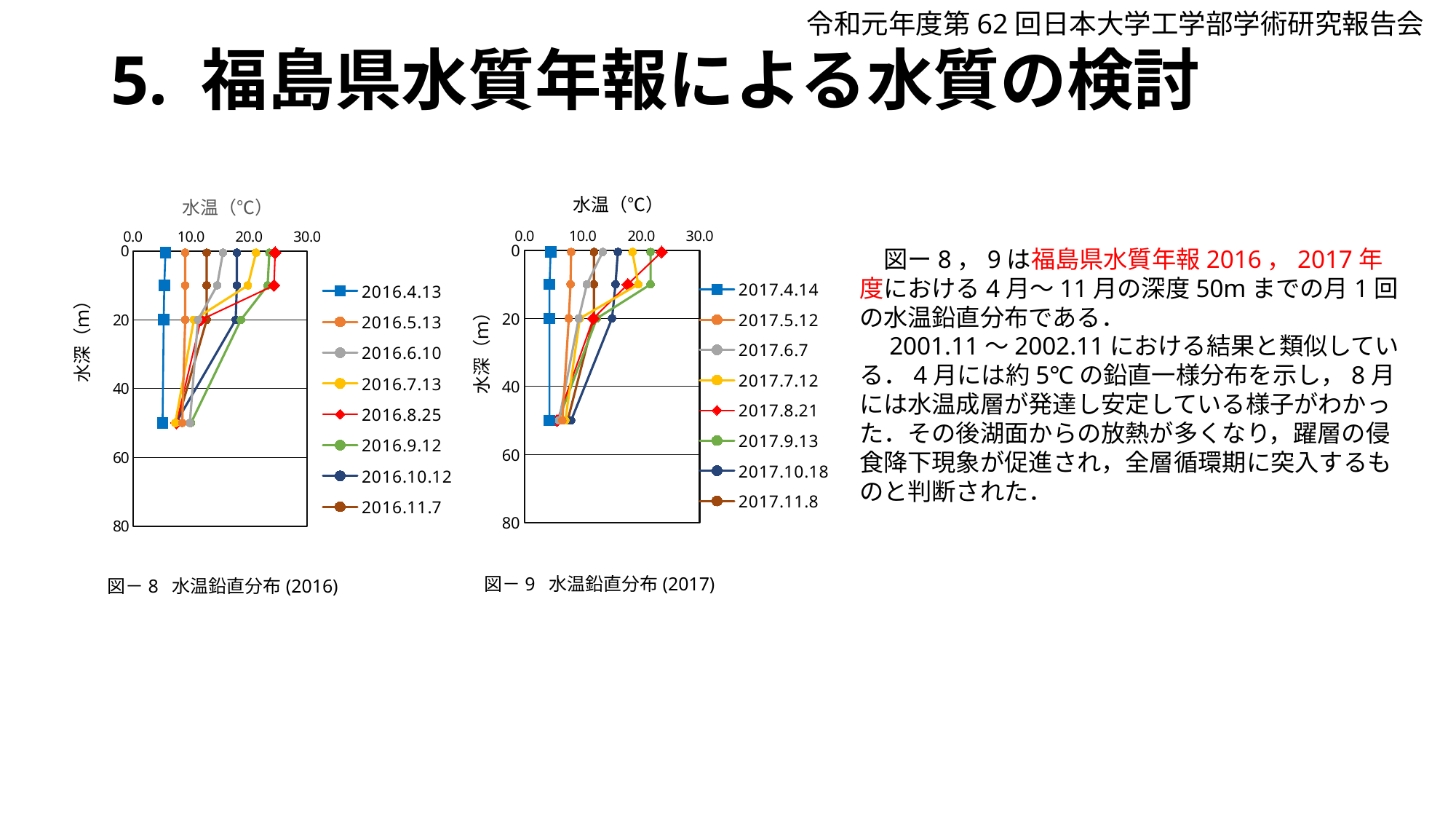
How many depth points are plotted for the 2017.8.21 series in 図－9 水温鉛直分布 (2017)? 4 How many series does the legend of 図－9 水温鉛直分布 (2017) list? 8 In 図－8 水温鉛直分布 (2016), is the surface (depth 0 m) water temperature for 2016.8.25 greater or less than 20.0? greater In 図－9 水温鉛直分布 (2017), is the surface (depth 0 m) water temperature for 2017.4.14 greater or less than 10.0? less In 図－8 水温鉛直分布 (2016), is the surface (depth 0 m) water temperature for 2016.4.13 greater or less than 10.0? less In 図－8 水温鉛直分布 (2016), does the water temperature for 2016.8.25 rise or fall as depth increases from 0 m to 50 m? fall What is the label of the vertical axis in 図－8 水温鉛直分布 (2016)? 水深（m） What kind of chart is 図－8 水温鉛直分布 (2016)? line chart In 図－9 水温鉛直分布 (2017), which series has the higher surface (depth 0 m) water temperature, 2017.5.12 or 2017.8.21? 2017.8.21 How many series does the legend of 図－8 水温鉛直分布 (2016) list? 8 In 図－8 水温鉛直分布 (2016), which series has the higher surface (depth 0 m) water temperature, 2016.4.13 or 2016.8.25? 2016.8.25